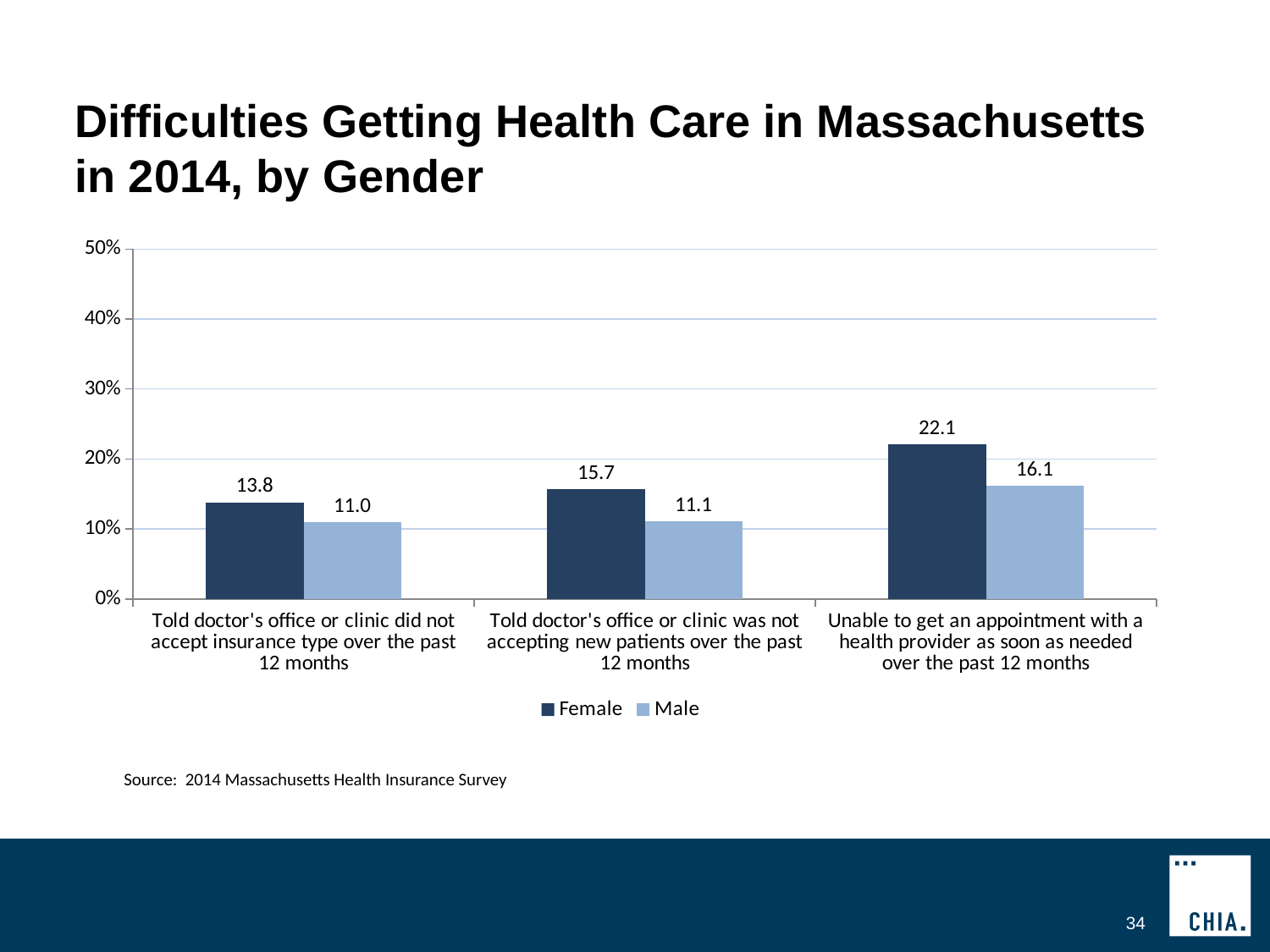
What is the Female value for 'Told doctor's office or clinic was not accepting new patients over the past 12 months'? 15.7 What is the Male value for 'Told doctor's office or clinic did not accept insurance type over the past 12 months'? 11.0 Which is larger for 'Told doctor's office or clinic was not accepting new patients over the past 12 months': the Female value or the Male value? Female How many series does the legend list? 2 What is the title of the chart on the slide? Difficulties Getting Health Care in Massachusetts in 2014, by Gender Is the Female value for 'Unable to get an appointment with a health provider as soon as needed over the past 12 months' greater or less than 20%? greater What kind of chart is shown on the slide? Bar chart What is the difference between the Female and Male values for 'Unable to get an appointment with a health provider as soon as needed over the past 12 months'? 6.0 Which category has the highest Female value? Unable to get an appointment with a health provider as soon as needed over the past 12 months What is the Female value for 'Unable to get an appointment with a health provider as soon as needed over the past 12 months'? 22.1 How many categories are shown on the x axis? 3 Which category has the lowest Male value? Told doctor's office or clinic did not accept insurance type over the past 12 months